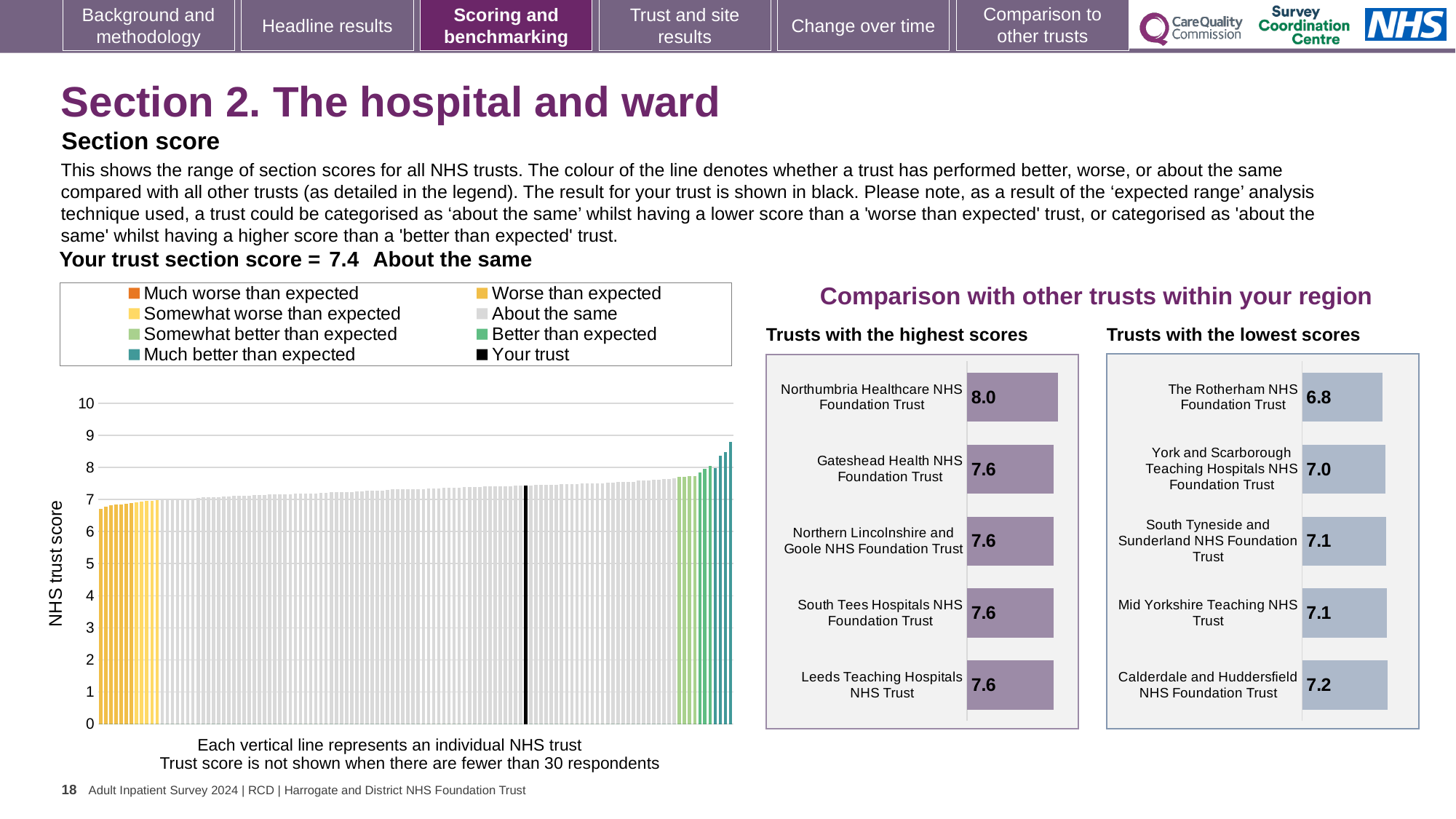
How many entries does the legend of the large chart on the left list? 8 In the large chart on the left, is the value for the black 'Your trust' bar greater or less than 7? greater In the 'Trusts with the highest scores' chart, which trust has the highest score? Northumbria Healthcare NHS Foundation Trust What is the y-axis label of the large chart on the left? NHS trust score In the 'Trusts with the lowest scores' chart, what is the score for Calderdale and Huddersfield NHS Foundation Trust? 7.2 In the 'Trusts with the lowest scores' chart, what is the score for The Rotherham NHS Foundation Trust? 6.8 In the 'Trusts with the highest scores' chart, what is the score for Northumbria Healthcare NHS Foundation Trust? 8.0 In the 'Trusts with the lowest scores' chart, which has the larger score: York and Scarborough Teaching Hospitals NHS Foundation Trust or Calderdale and Huddersfield NHS Foundation Trust? Calderdale and Huddersfield NHS Foundation Trust What kind of chart is the 'Trusts with the highest scores' chart? Bar chart In the 'Trusts with the lowest scores' chart, which trust has the lowest score? The Rotherham NHS Foundation Trust How many trusts are listed in the 'Trusts with the lowest scores' chart? 5 In the 'Trusts with the highest scores' chart, what is the difference between the scores of Northumbria Healthcare NHS Foundation Trust and Gateshead Health NHS Foundation Trust? 0.4